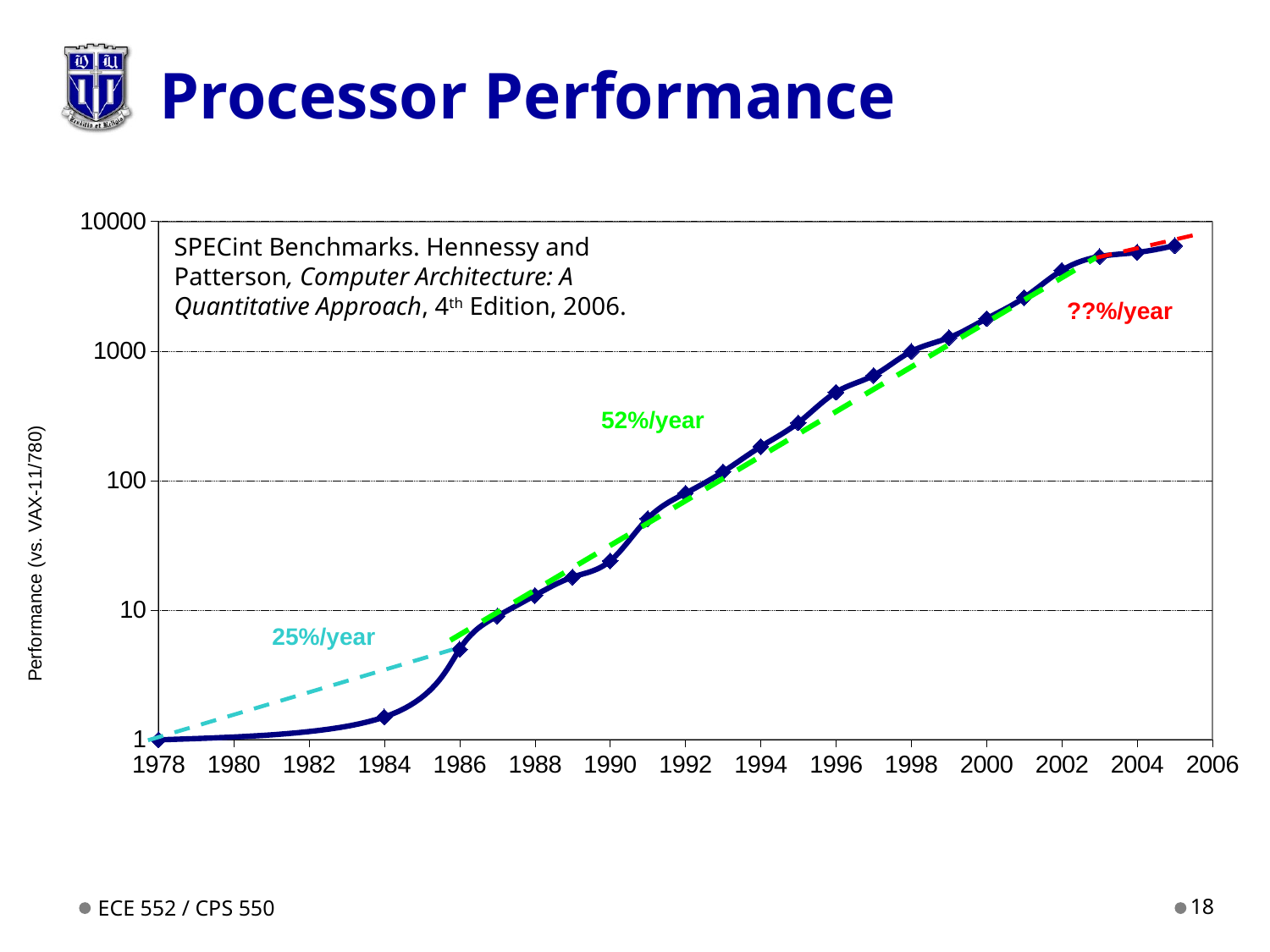
What is the label on the vertical axis of the chart? Performance (vs. VAX-11/780) What annual growth rate is annotated on the green dashed trend line? 52%/year Is the performance value for 1990 greater or less than 100? less Do the plotted performance values rise or fall from 1978 to 2005? rise What is the performance value plotted for 1978? 1 What kind of chart is shown on the slide? line chart Which year has the lowest plotted performance value? 1978 Which year has the larger performance value, 1984 or 1992? 1992 Is the performance value for 1986 greater or less than 10? less Is the performance value for 1996 greater or less than 1000? less